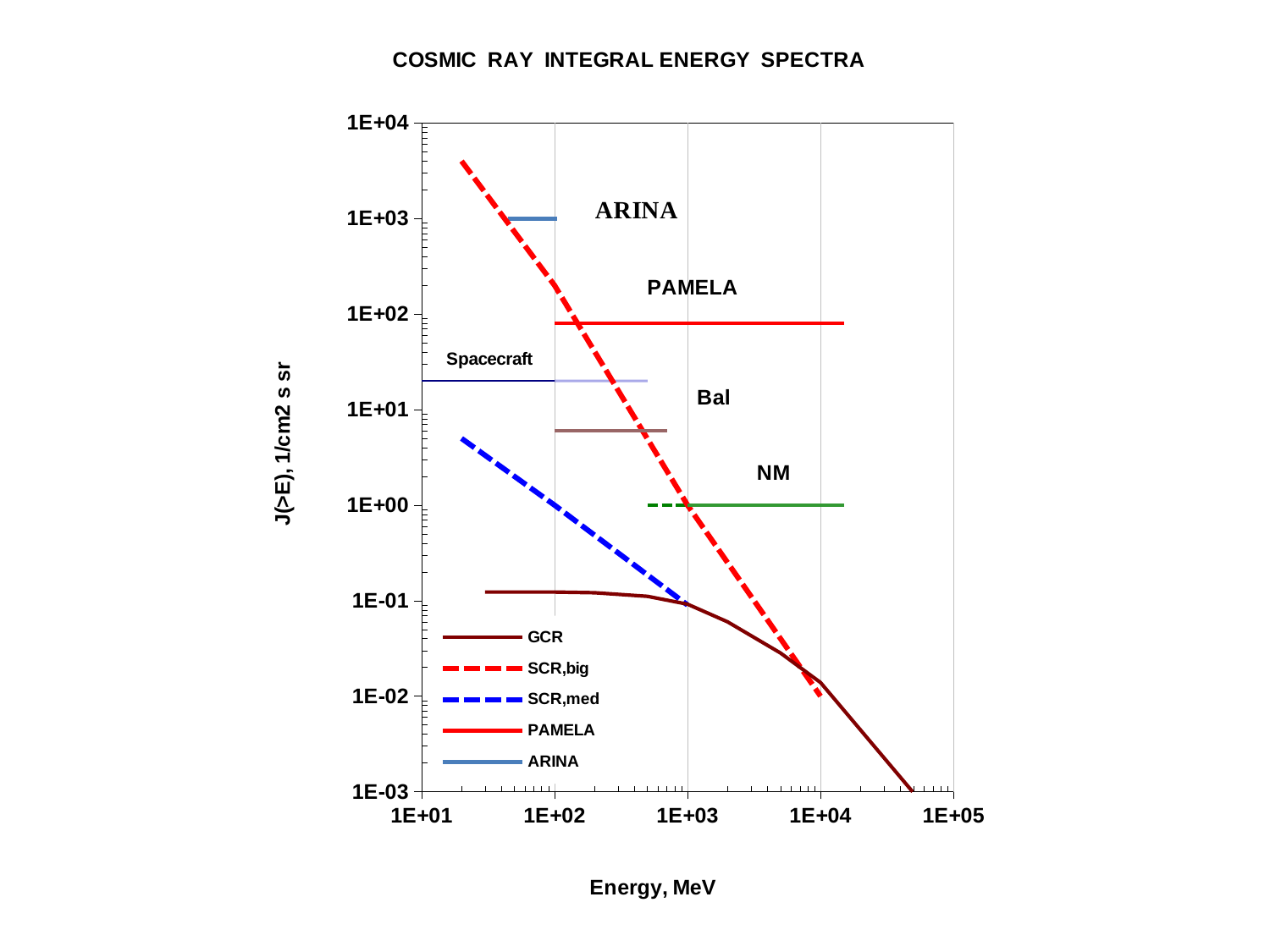
Does the GCR curve rise or fall as energy increases? fall Is the value of the ARINA line greater or less than 1E+02? greater At an energy of 1E+02 MeV, which is larger, SCR,big or SCR,med? SCR,big Is the value of the PAMELA line greater or less than 1E+01? greater Does the SCR,big curve rise or fall as energy increases? fall What kind of chart is shown on the slide? line chart Which of the labelled horizontal lines (ARINA, PAMELA, Spacecraft, Bal, NM) is highest on the chart? ARINA How many series does the legend list? 5 Which of the labelled horizontal lines (ARINA, PAMELA, Spacecraft, Bal, NM) is lowest on the chart? NM Is the value of the Bal line greater or less than 1E+01? less What is the title of the chart? COSMIC RAY INTEGRAL ENERGY SPECTRA What is the label of the x axis? Energy, MeV